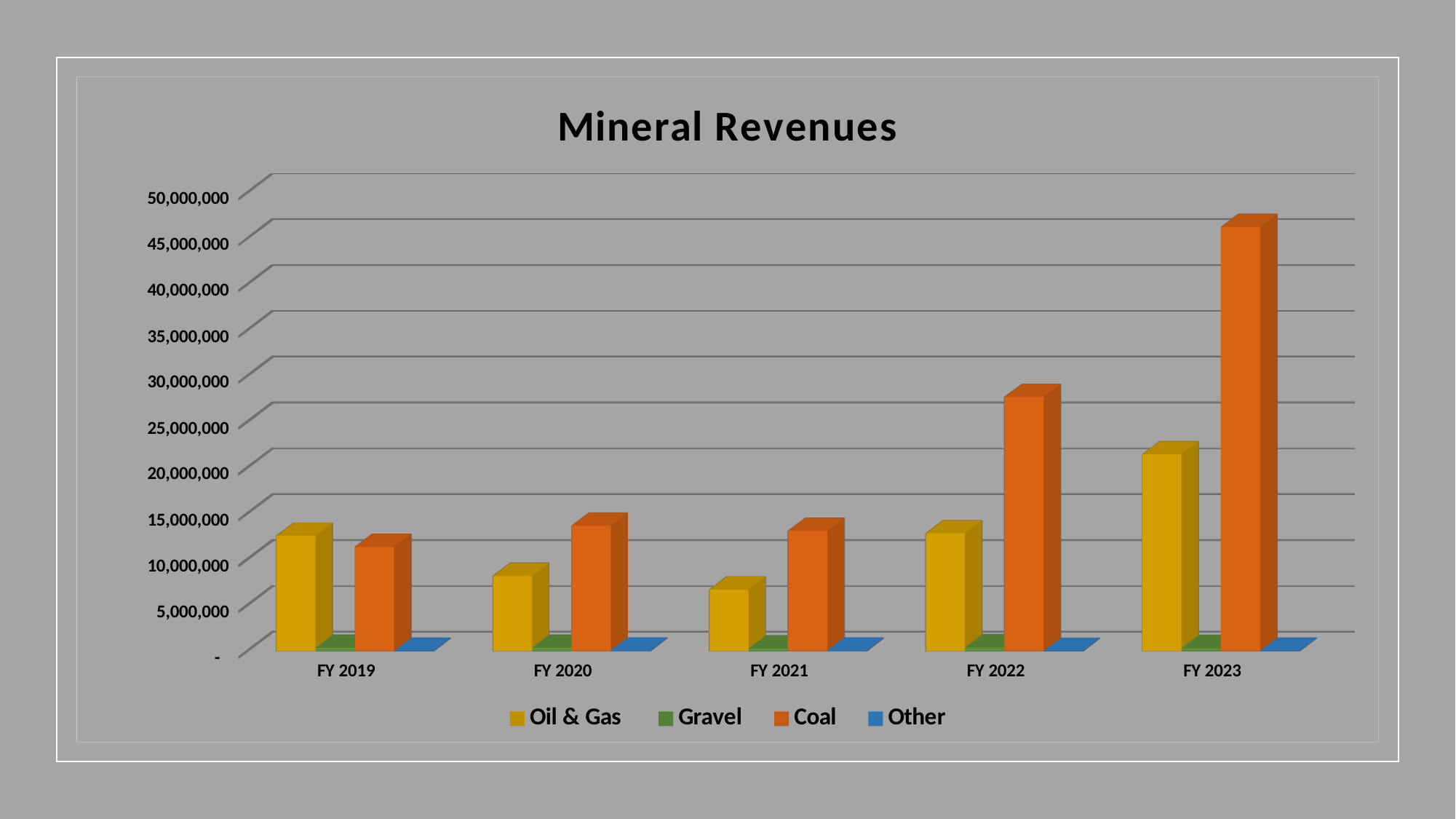
In which fiscal year is Coal revenue highest? FY 2023 Is the Coal value for FY 2023 greater or less than 40,000,000? greater In which fiscal year is Oil & Gas revenue lowest? FY 2021 In FY 2019, which is larger, Oil & Gas or Coal? Oil & Gas What kind of chart is shown on the slide? bar chart How many fiscal years are shown on the x axis? 5 How many series does the legend list? 4 Does Coal revenue rise or fall from FY 2021 to FY 2023? rise In FY 2022, which is larger, Oil & Gas or Coal? Coal Is the Oil & Gas value for FY 2021 greater or less than 10,000,000? less Is the Coal value for FY 2022 greater or less than 25,000,000? greater What is the title of the chart? Mineral Revenues